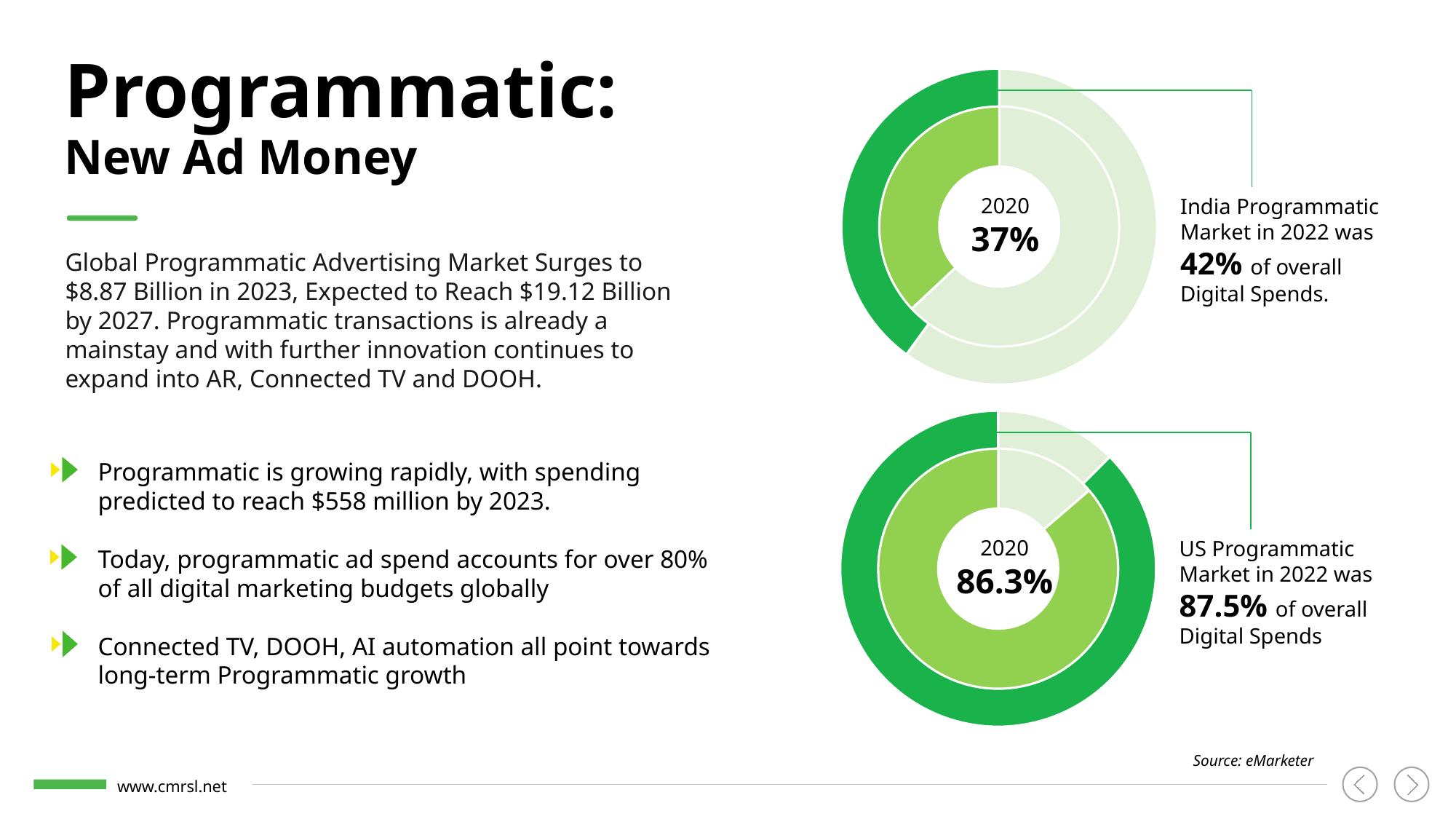
Which market had the smaller programmatic share of digital spends in 2020, India or the US? India In the top donut chart (India), what share of overall digital spends was programmatic in 2020? 37% What kind of chart is used to show the India and US programmatic shares? Donut chart What is the source cited for the charts on the slide? eMarketer In the top donut chart (India), did the programmatic share rise or fall from 2020 to 2022? rise Which market had the larger programmatic share of digital spends in 2022, India or the US? US In the bottom donut chart (US), what share of overall digital spends was programmatic in 2020? 86.3% In the bottom donut chart (US), by how many percentage points did the programmatic share grow from 2020 to 2022? 1.2 percentage points In the top donut chart (India), what share of overall digital spends was programmatic in 2022? 42% In the top donut chart (India), by how many percentage points did the programmatic share grow from 2020 to 2022? 5 percentage points In the bottom donut chart (US), what share of overall digital spends was programmatic in 2022? 87.5%